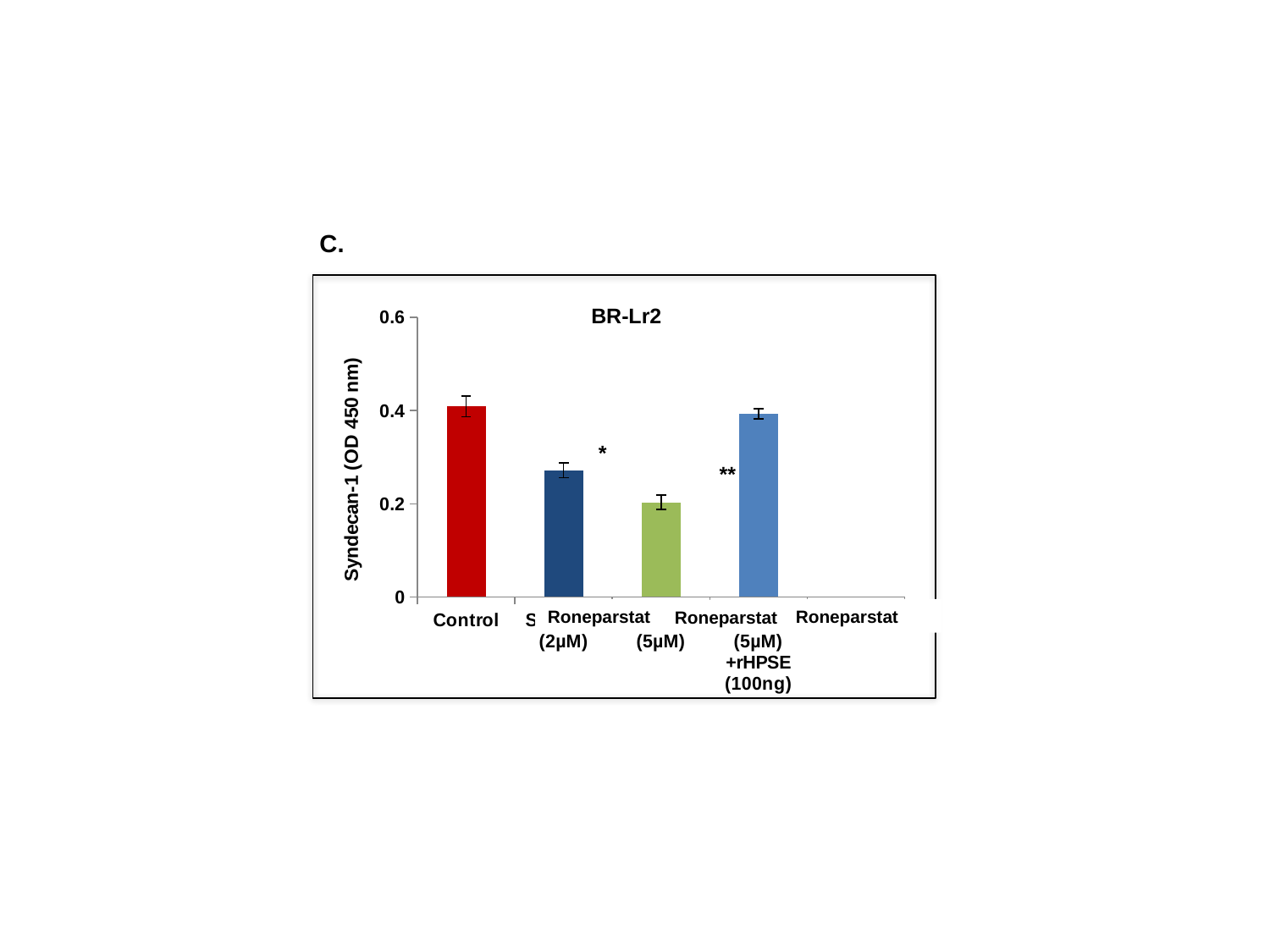
Which is larger, the value for Roneparstat (2µM) or the value for Roneparstat (5µM)? Roneparstat (2µM) Is the value for Control greater or less than 0.2? greater How many bars are plotted in the chart? 4 Is the value for Roneparstat (5µM) +rHPSE (100ng) greater or less than 0.2? greater Is the value for Roneparstat (2µM) greater or less than 0.2? greater Which is larger, the value for Control or the value for Roneparstat (2µM)? Control What is the label of the y axis? Syndecan-1 (OD 450 nm) What kind of chart is shown on the slide? bar chart Which category has the lowest Syndecan-1 value? Roneparstat (5µM) What is the title of the chart? BR-Lr2 Which is larger, the value for Roneparstat (5µM) or the value for Roneparstat (5µM) +rHPSE (100ng)? Roneparstat (5µM) +rHPSE (100ng)